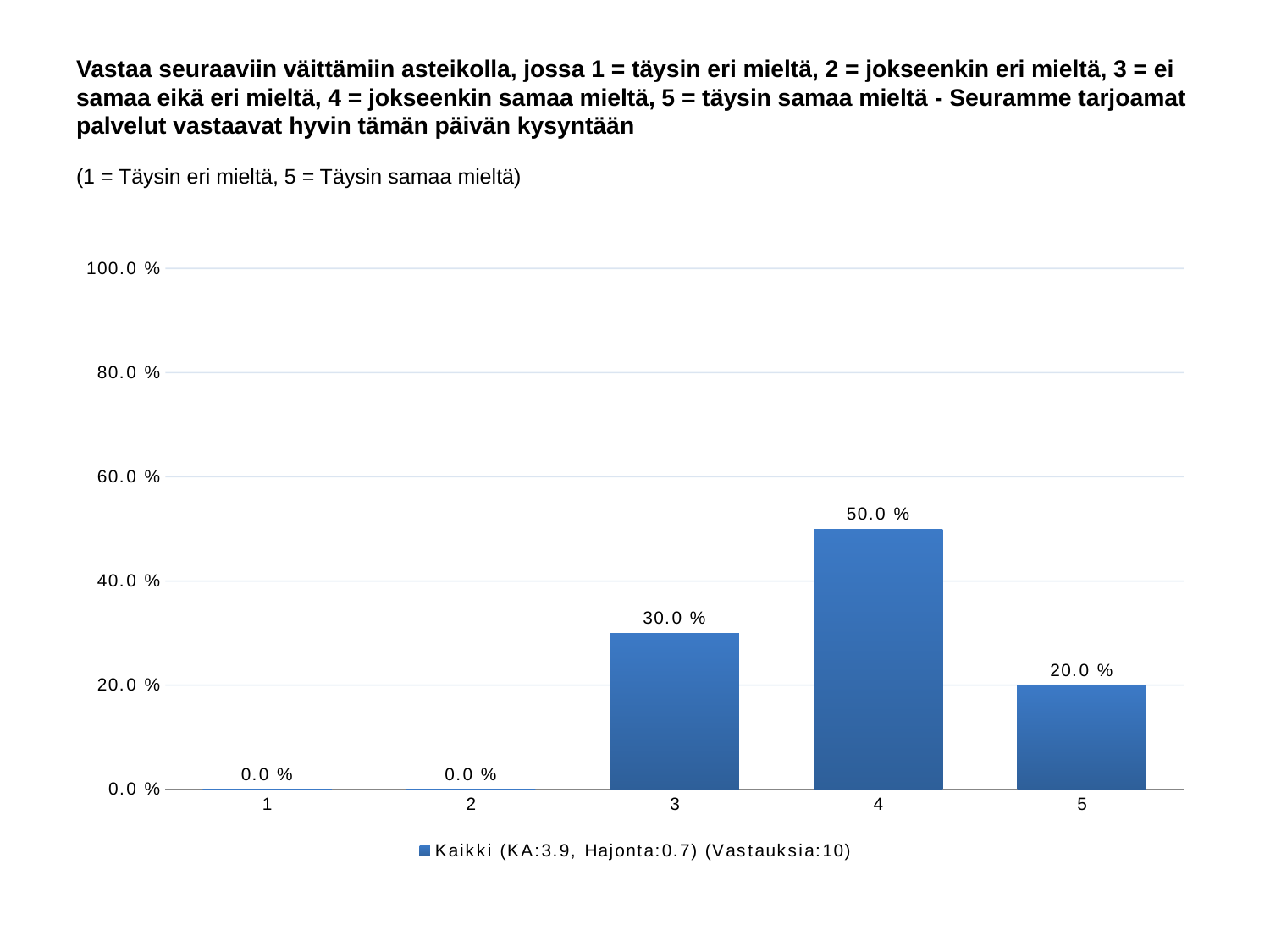
Is the value for category 4 greater or less than 40.0 %? greater How many responses (Vastauksia) does the legend entry report? 10 What kind of chart is shown on the slide? bar chart What is the value for category 4? 50.0 % Which is larger, the value for category 3 or category 5? 3 Which category has the highest value? 4 What is the difference between the values for categories 3 and 5? 10.0 % What is the value for category 5? 20.0 % How many categories are shown on the x axis? 5 What is the difference between the values for categories 4 and 3? 20.0 % What is the value for category 1? 0.0 % What is the value for category 3? 30.0 %